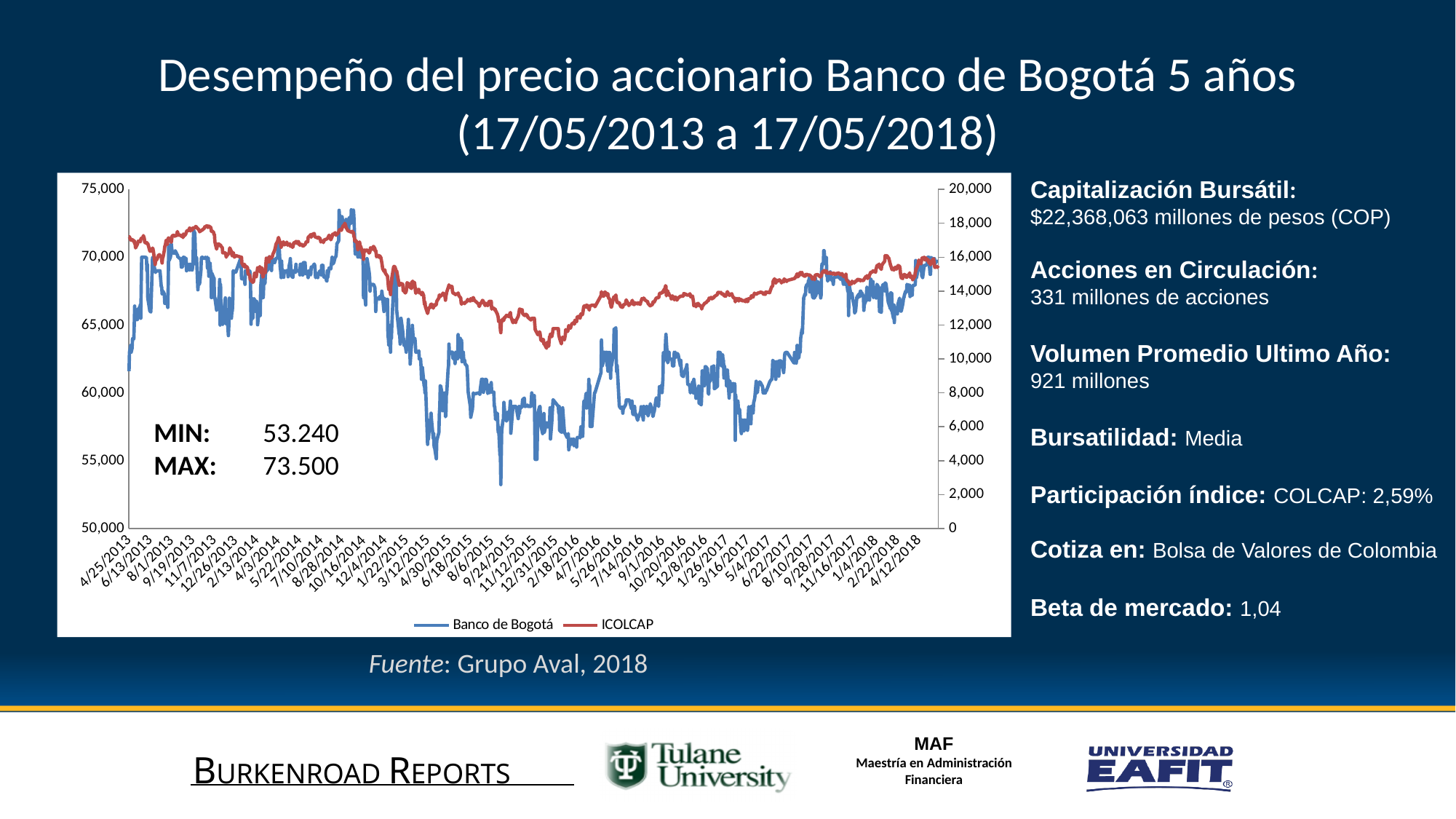
What colour is the ICOLCAP line in the chart? red What is the MIN value printed on the chart? 53.240 Does the Banco de Bogotá line rise or fall between 10/16/2014 and 9/24/2015? fall How many series does the chart's legend list? 2 Which two series are listed in the chart's legend? Banco de Bogotá and ICOLCAP What kind of chart is shown on the slide? line chart Is the value of the Banco de Bogotá line around 9/24/2015 greater or less than 60,000? less What is the MAX value printed on the chart? 73.500 Is the value of the ICOLCAP line around 11/12/2015 greater or less than 14,000? less Does the ICOLCAP line rise or fall between 11/12/2015 and 4/12/2018? rise Is the lowest value of the Banco de Bogotá line greater or less than 55,000? less